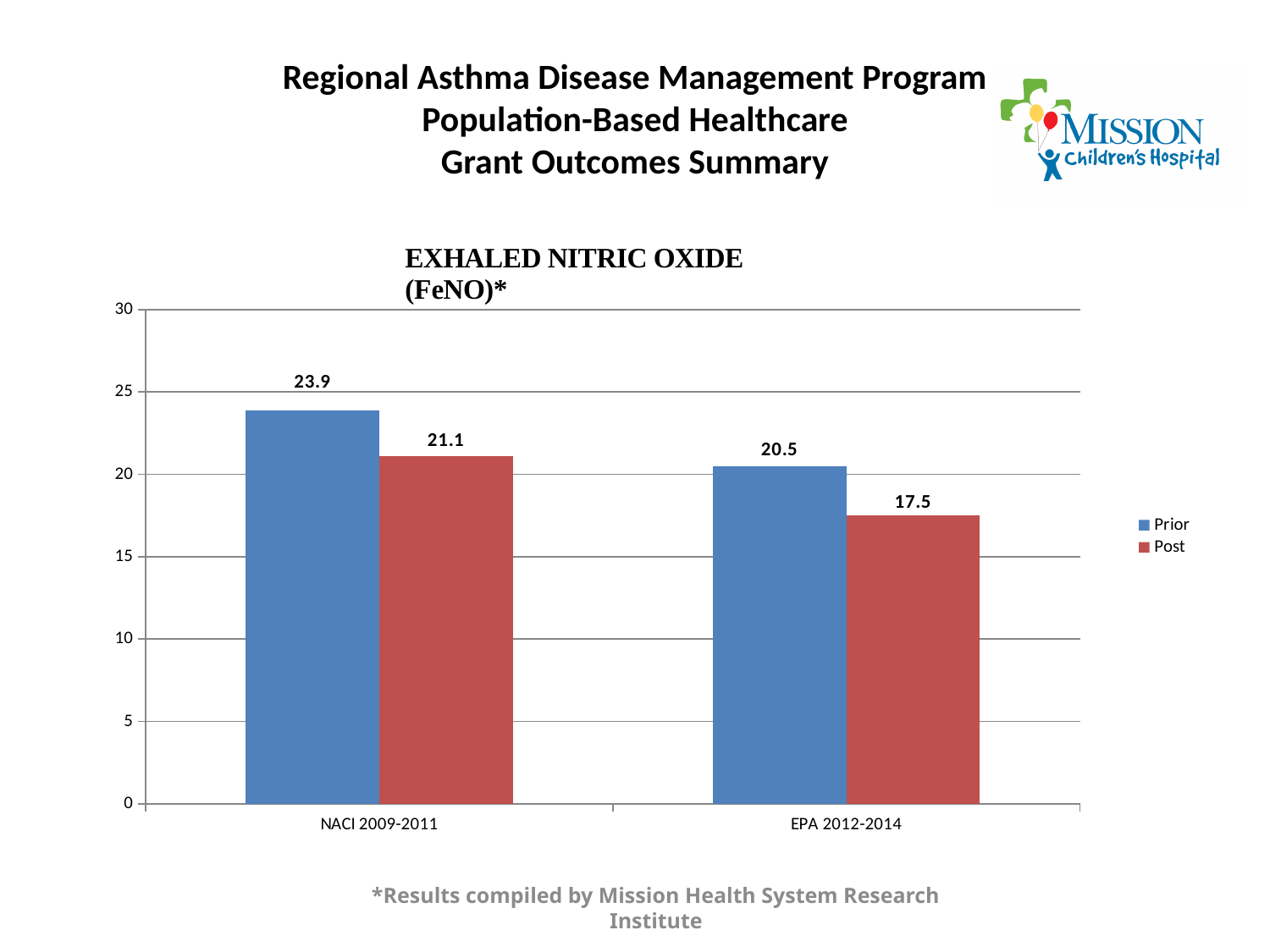
What is the Post value for EPA 2012-2014? 17.5 Which is larger for EPA 2012-2014, the Prior value or the Post value? Prior What kind of chart is shown on the slide? Bar chart Which bar has the lowest value on the chart? Post, EPA 2012-2014 What is the difference between the Prior and Post values for NACI 2009-2011? 2.8 What is the Prior value for NACI 2009-2011? 23.9 How many series does the legend list? 2 What is the Post value for NACI 2009-2011? 21.1 How many categories are shown on the x axis? 2 What is the difference between the Prior and Post values for EPA 2012-2014? 3.0 What is the Prior value for EPA 2012-2014? 20.5 Which bar has the highest value on the chart? Prior, NACI 2009-2011